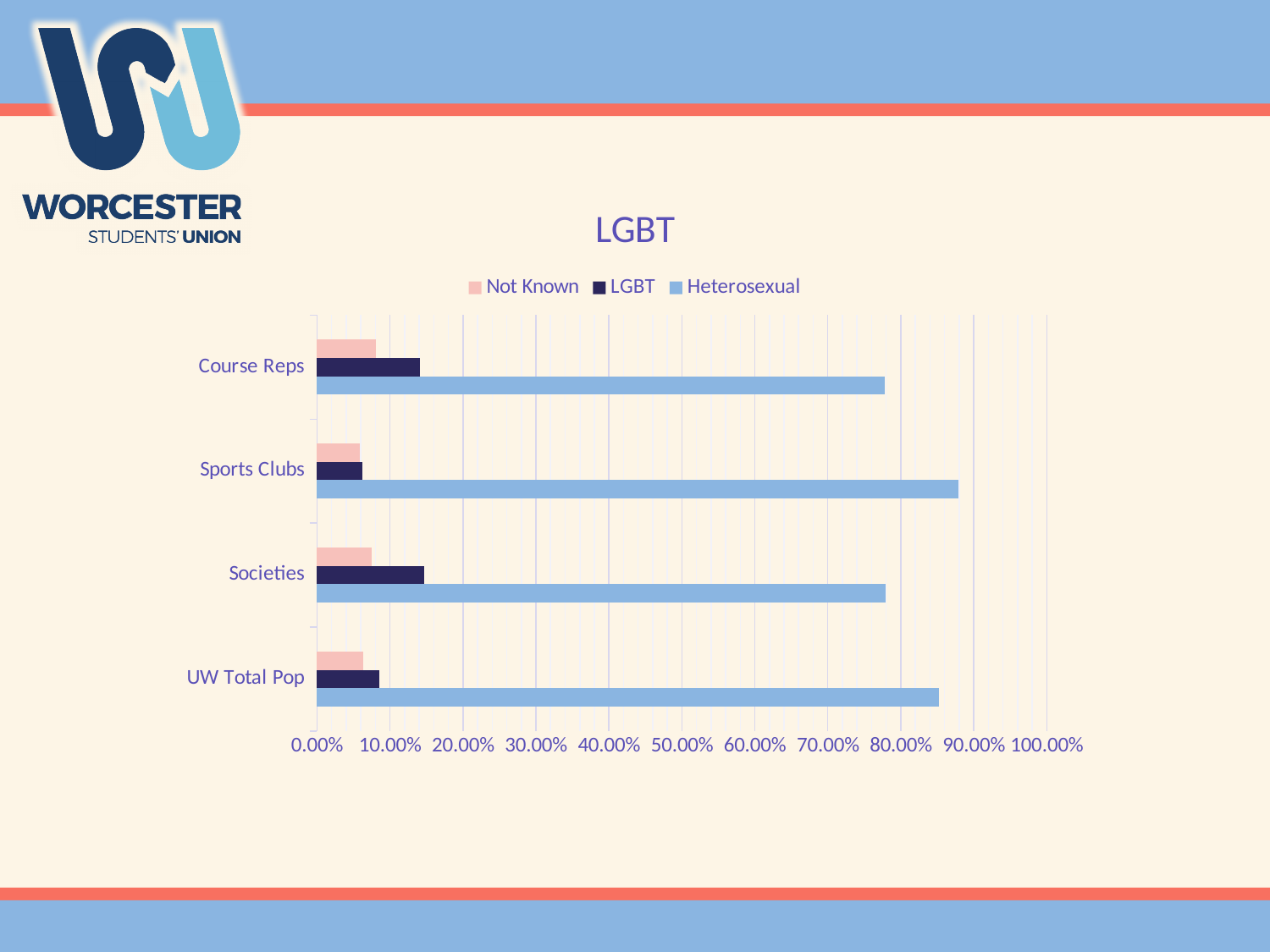
What kind of chart is shown on the slide? bar chart Is the Heterosexual value for Sports Clubs greater or less than 80.00%? greater Which is larger: the LGBT value for Course Reps or the LGBT value for UW Total Pop? Course Reps Is the LGBT value for Sports Clubs greater or less than 10.00%? less How many series does the legend list? 3 Which category has the highest Heterosexual value? Sports Clubs Which legend entry is shown in the lightest pink colour? Not Known How many categories are shown on the vertical axis of the chart? 4 Is the LGBT value for Societies greater or less than 10.00%? greater What is the title of the chart? LGBT Which is larger: the Heterosexual value for Sports Clubs or the Heterosexual value for Societies? Sports Clubs